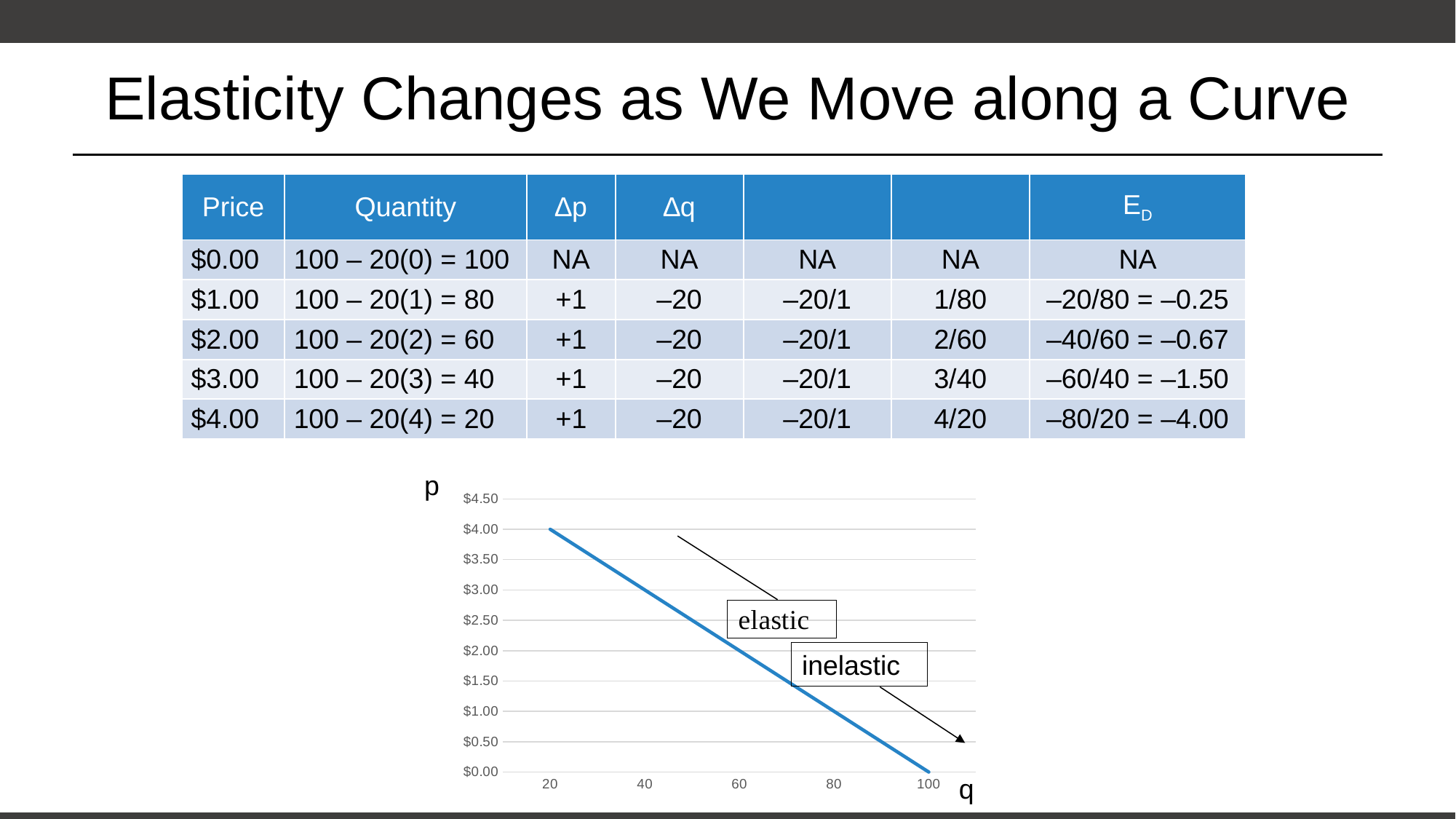
At which q value shown on the x axis is p lowest? 100 What two text labels are placed along the line in the chart? elastic and inelastic What is the value of p where the line meets q = 20? $4.00 What is the value of p where the line meets q = 100? $0.00 Does the plotted line rise or fall as q increases along the x axis? fall What kind of chart is shown on the slide? line chart How many tick labels are shown on the x axis of the chart? 5 Is the value of p at q = 80 greater or less than $1.50? less What is the value of p where the line crosses q = 60? $2.00 Which is larger, the value of p at q = 40 or at q = 80? q = 40 At which q value shown on the x axis is p highest? 20 Is the value of p at q = 40 greater or less than $2.50? greater